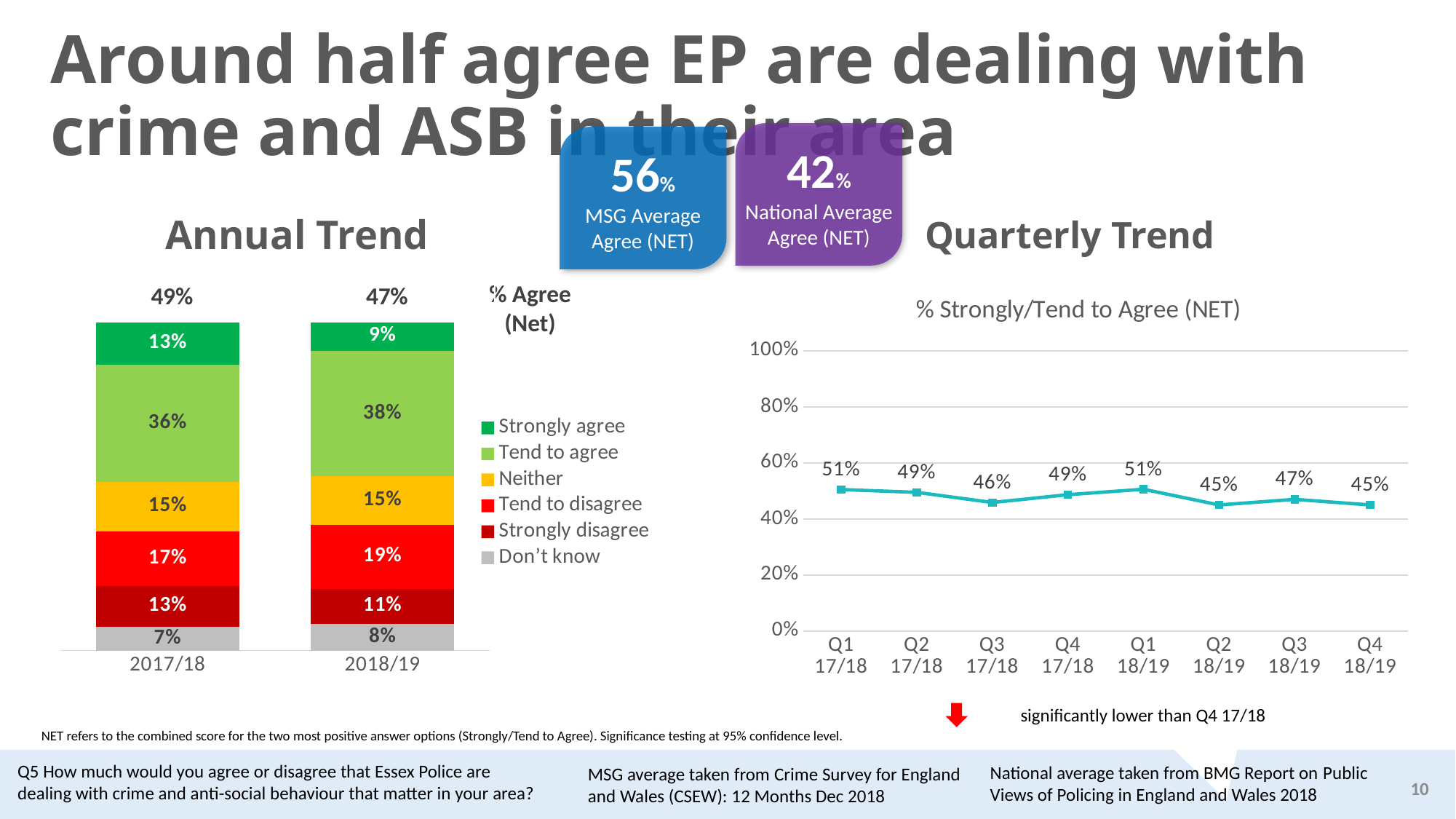
In the Quarterly Trend chart, what is the value for Q3 17/18? 46% In the Annual Trend chart, what is the Tend to agree value for 2018/19? 38% What kind of chart is the Annual Trend chart? Stacked bar chart In the Quarterly Trend chart, which quarter has the lowest value? Q2 18/19 and Q4 18/19 (45%) In the Quarterly Trend chart, what is the difference between Q1 18/19 and Q4 18/19? 6% In the Annual Trend chart, what is the difference between the Tend to disagree values for 2018/19 and 2017/18? 2% In the Annual Trend chart, which year has the larger Strongly disagree value, 2017/18 or 2018/19? 2017/18 In the Annual Trend chart, what is the Strongly agree value for 2017/18? 13% How many series does the legend of the Annual Trend chart list? 6 How many quarters are plotted in the Quarterly Trend chart? 8 In the Annual Trend chart, what is the % Agree (Net) for 2018/19? 47% What kind of chart is the Quarterly Trend chart? Line chart